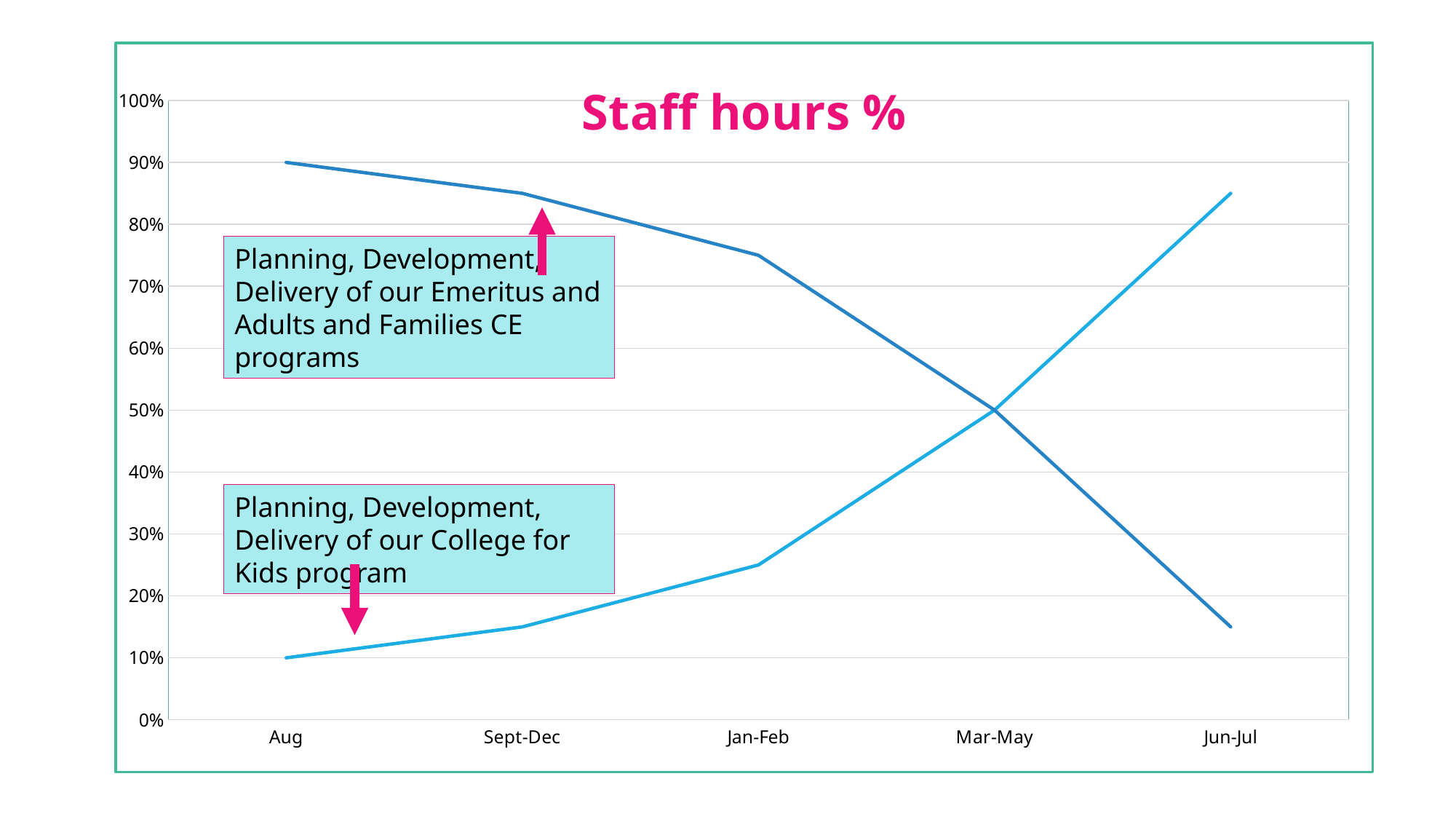
What is the value of the College for Kids program line in Mar-May? 50% Is the value of the Emeritus and Adults and Families CE programs line in Jan-Feb greater or less than 70%? greater What is the value of the College for Kids program line in Aug? 10% Does the College for Kids program line rise or fall from Aug to Jun-Jul? rise What kind of chart is shown on the slide? line chart What is the value of the Emeritus and Adults and Families CE programs line in Aug? 90% In which period does the Emeritus and Adults and Families CE programs line reach its lowest value? Jun-Jul Which line is higher in Jan-Feb, the Emeritus and Adults and Families CE programs line or the College for Kids program line? Emeritus and Adults and Families CE programs How many time periods are shown on the x axis? 5 Is the value of the College for Kids program line in Jun-Jul greater or less than 80%? greater What is the title of the chart? Staff hours % Is the value of the Emeritus and Adults and Families CE programs line in Jun-Jul greater or less than 20%? less